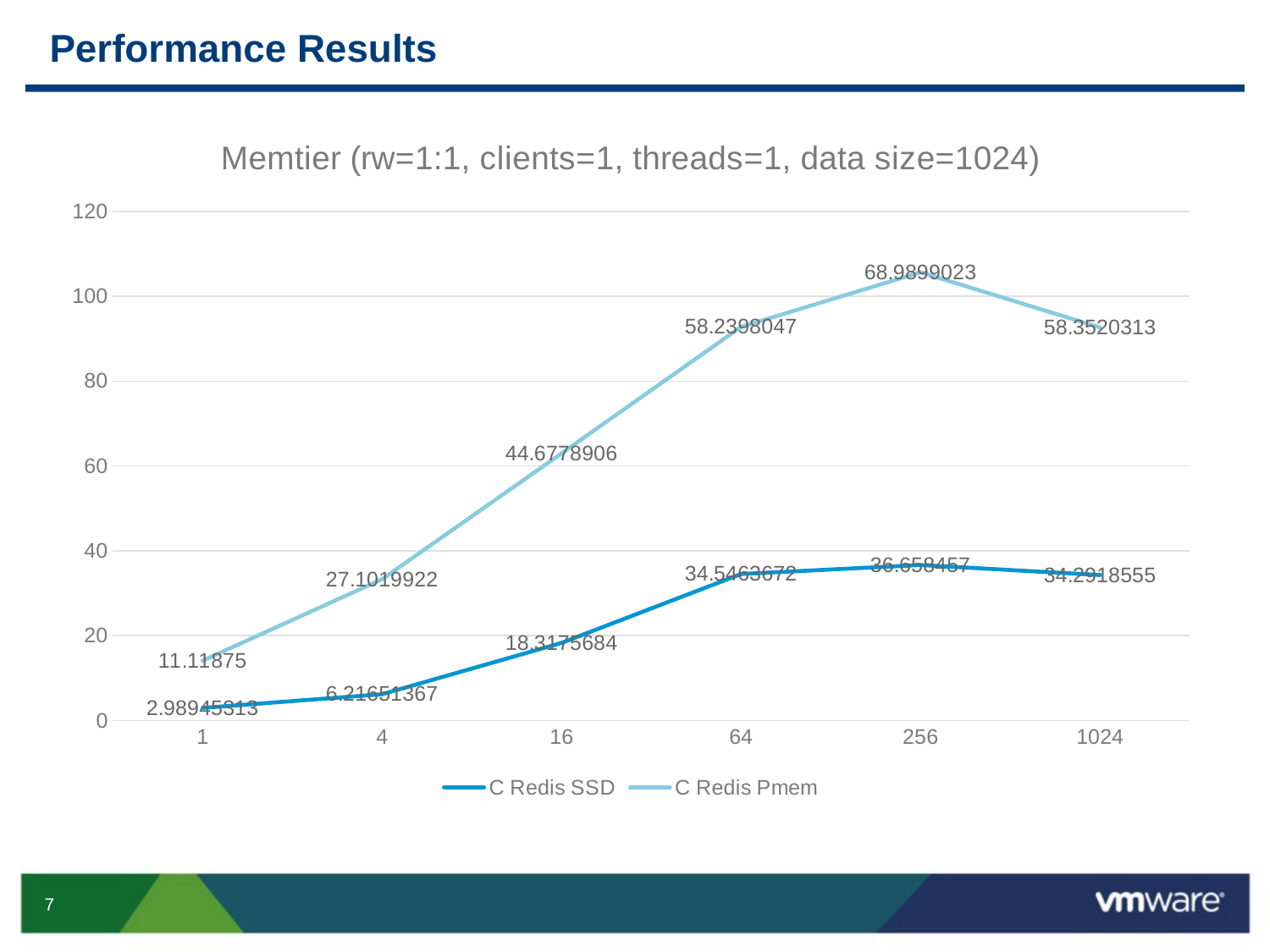
At which x value does C Redis Pmem have its lowest labelled value? 1 What is the difference between the labelled values of C Redis Pmem and C Redis SSD at x = 1024? 24.0601758 What is the labelled value for C Redis SSD at x = 16? 18.3175684 What is the labelled value for C Redis Pmem at x = 256? 68.9899023 At which x value does C Redis SSD reach its highest labelled value? 256 How many series does the legend list? 2 What is the labelled value for C Redis Pmem at x = 1? 11.11875 What kind of chart is shown on the slide? Line chart Does the C Redis SSD line rise or fall from x = 1 to x = 64? Rise At x = 64, which series has the larger value, C Redis SSD or C Redis Pmem? C Redis Pmem What is the title of the chart? Memtier (rw=1:1, clients=1, threads=1, data size=1024) How many points are plotted along the x axis for each series? 6